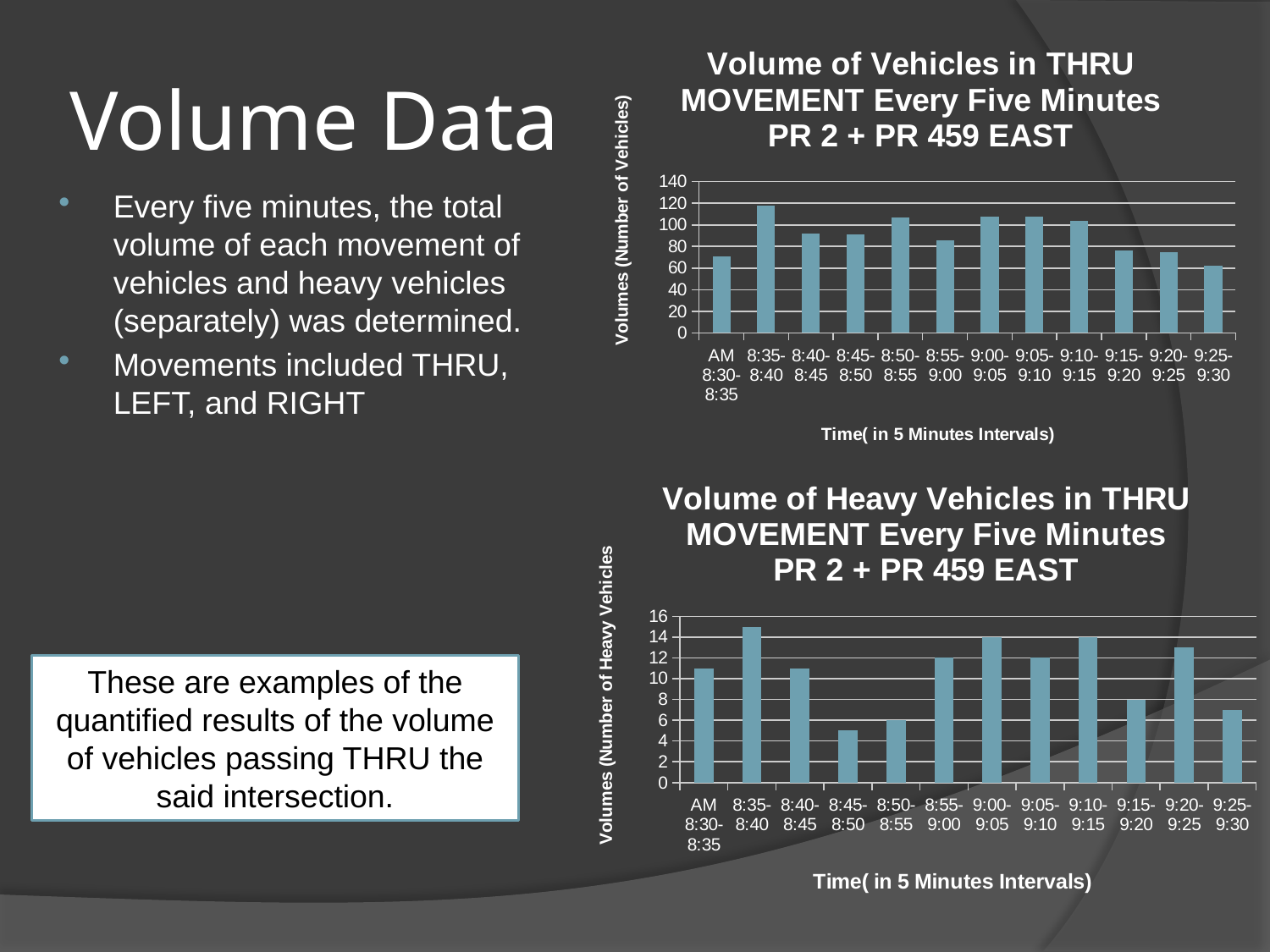
In the bottom chart (Volume of Heavy Vehicles in THRU MOVEMENT), is the value for 8:45-8:50 greater or less than 8? less In the top chart (Volume of Vehicles in THRU MOVEMENT), is the value for 8:35-8:40 greater or less than 100? greater In the bottom chart (Volume of Heavy Vehicles in THRU MOVEMENT), which is larger, the value for 8:35-8:40 or the value for 8:45-8:50? 8:35-8:40 In the top chart (Volume of Vehicles in THRU MOVEMENT), which time interval has the lowest volume? 9:25-9:30 In the top chart (Volume of Vehicles in THRU MOVEMENT), which time interval has the highest volume? 8:35-8:40 How many time intervals are plotted in the top chart (Volume of Vehicles in THRU MOVEMENT)? 12 In the bottom chart (Volume of Heavy Vehicles in THRU MOVEMENT), what is the value for 9:00-9:05? 14 In the top chart (Volume of Vehicles in THRU MOVEMENT), is the value for AM 8:30-8:35 greater or less than 80? less In the top chart (Volume of Vehicles in THRU MOVEMENT), which is larger, the value for 8:50-8:55 or the value for 8:55-9:00? 8:50-8:55 In the bottom chart (Volume of Heavy Vehicles in THRU MOVEMENT), what is the value for 9:15-9:20? 8 What kind of chart is the bottom chart (Volume of Heavy Vehicles in THRU MOVEMENT)? bar chart In the bottom chart (Volume of Heavy Vehicles in THRU MOVEMENT), what is the value for 8:50-8:55? 6